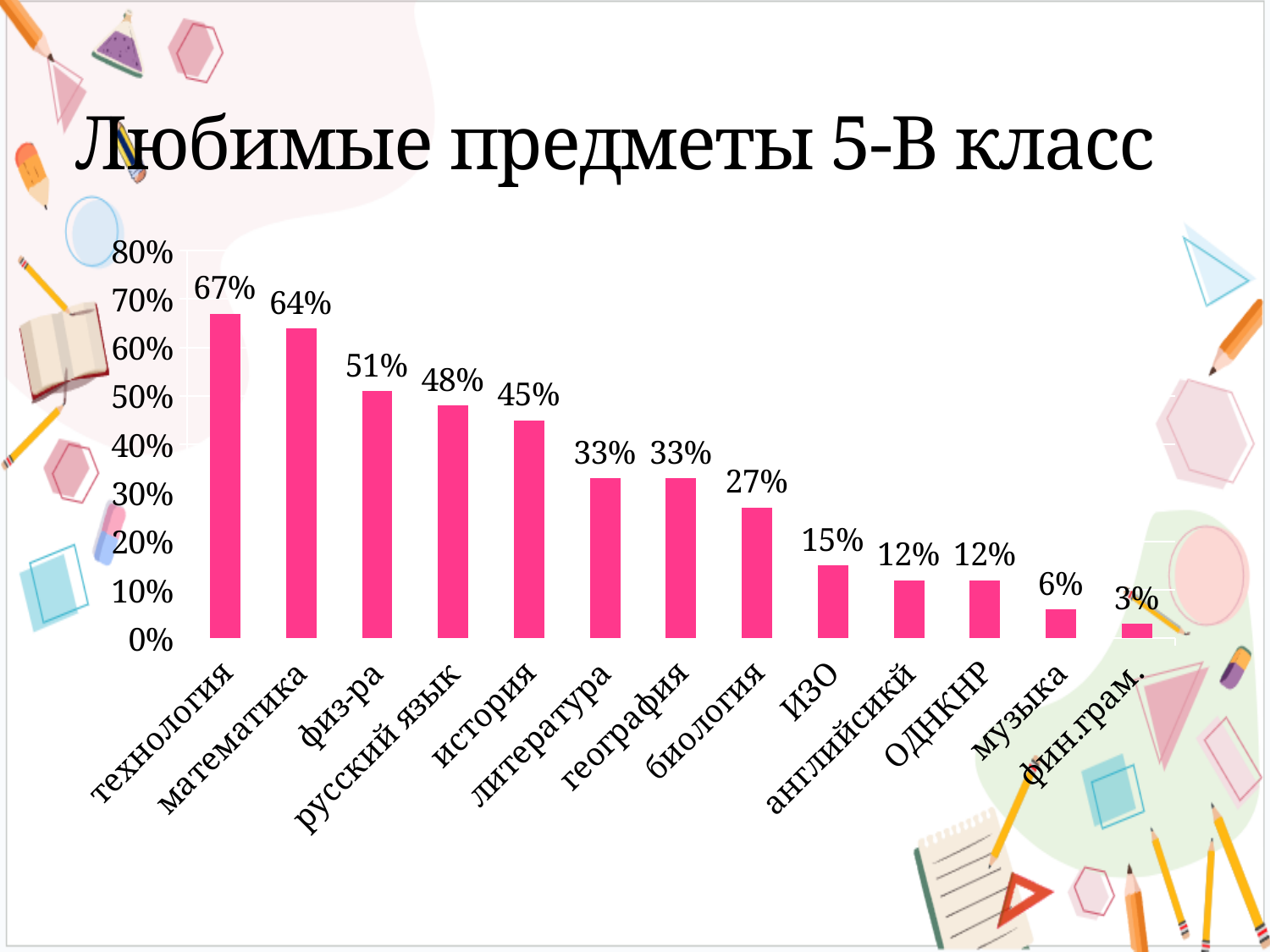
Which subject has the lowest value? фин.грам. What is the value for технология? 67% What kind of chart is shown on the slide? bar chart Is the value for ИЗО greater or less than 20%? less How many subjects are shown on the chart? 13 Which is larger, the value for русский язык or the value for литература? русский язык What is the value for биология? 27% Which subject has the highest value? технология What is the value for история? 45% Do the values rise or fall from left to right along the x axis? fall What is the difference between the values for математика and физ-ра? 13% What is the title of the slide? Любимые предметы 5-В класс